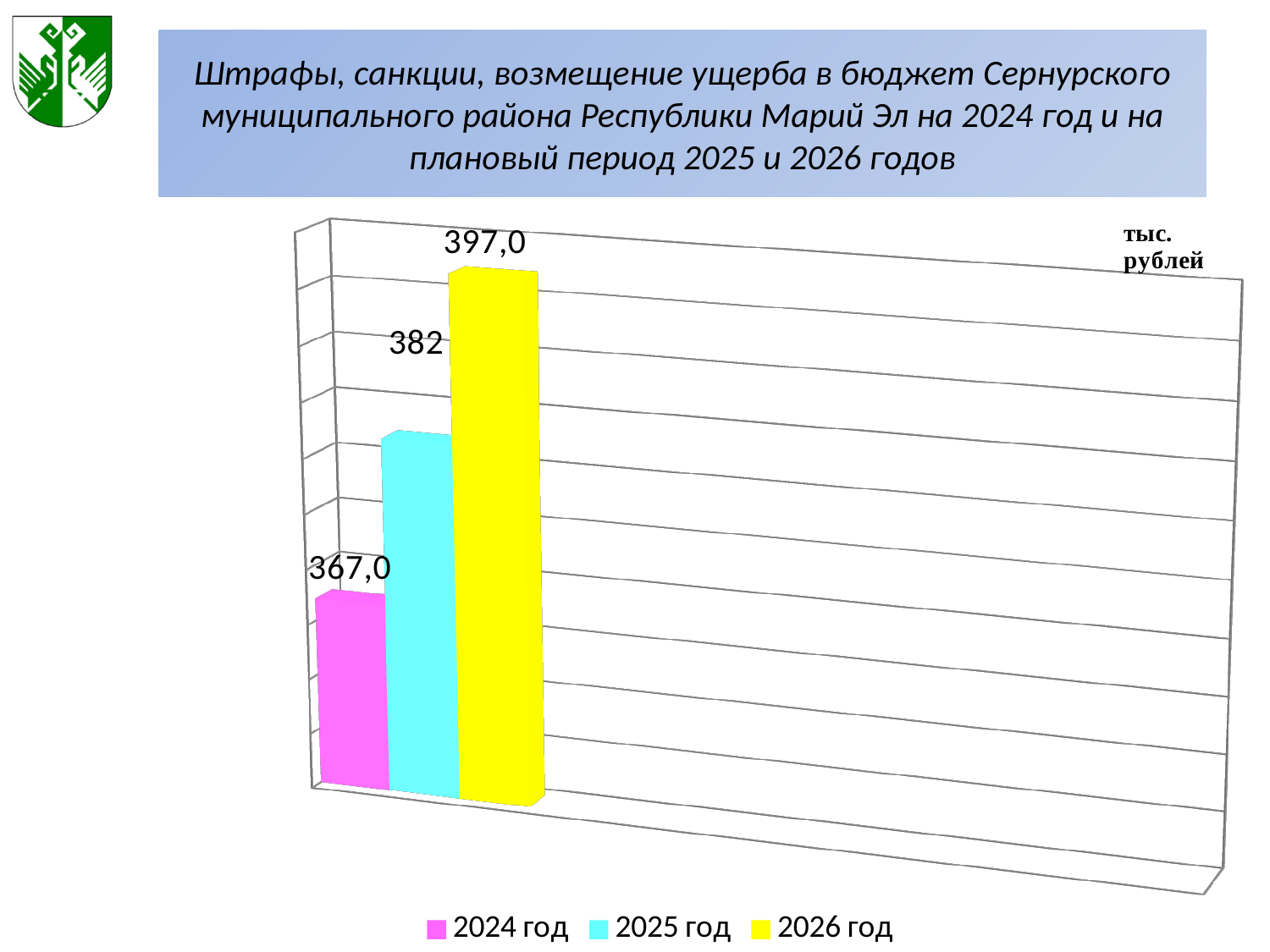
What is the difference between the values for 2026 год and 2024 год? 30,0 Do the values rise or fall from 2024 год to 2026 год? rise Which is larger, the value for 2025 год or the value for 2026 год? 2026 год What is the value for 2024 год? 367,0 What is the value for 2026 год? 397,0 What is the value for 2025 год? 382 What is the difference between the values for 2025 год and 2024 год? 15,0 How many bars are plotted on the chart? 3 What kind of chart is shown on the slide? bar chart How many series does the legend list? 3 Which year has the lowest value? 2024 год Which year has the highest value? 2026 год